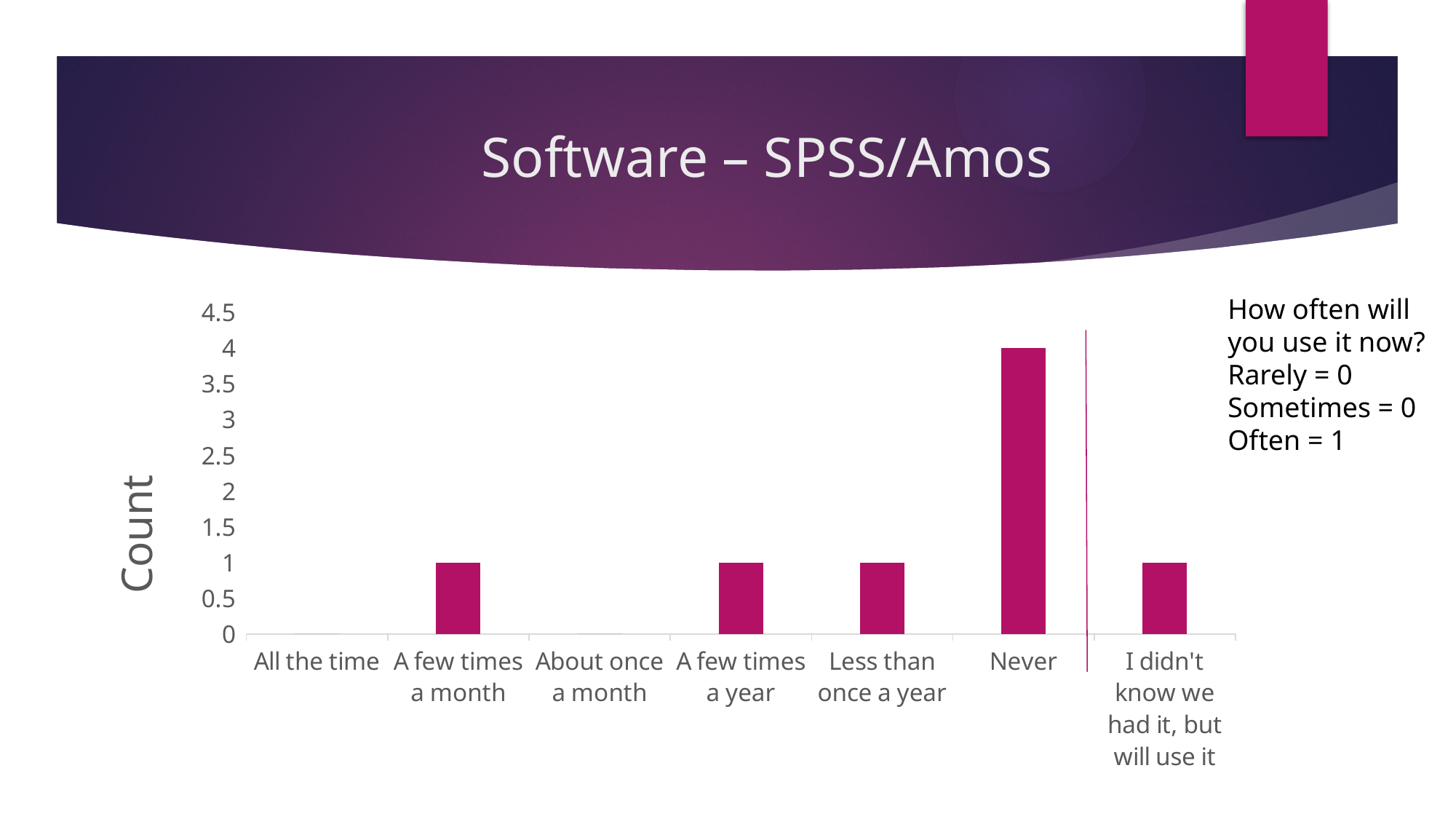
Which is larger, the count for "Never" or the count for "I didn't know we had it, but will use it"? Never What is the count for "All the time"? 0 What is the count for "Never"? 4 Which category has the highest count? Never What is the difference between the count for "Never" and the count for "A few times a year"? 3 What is the count for "A few times a month"? 1 What is the label of the vertical axis? Count How many categories are shown on the x axis of the chart? 7 What is the count for "Less than once a year"? 1 Is the count for "Never" greater or less than 3? greater What kind of chart is shown on the slide? bar chart What is the title of the slide containing the chart? Software – SPSS/Amos